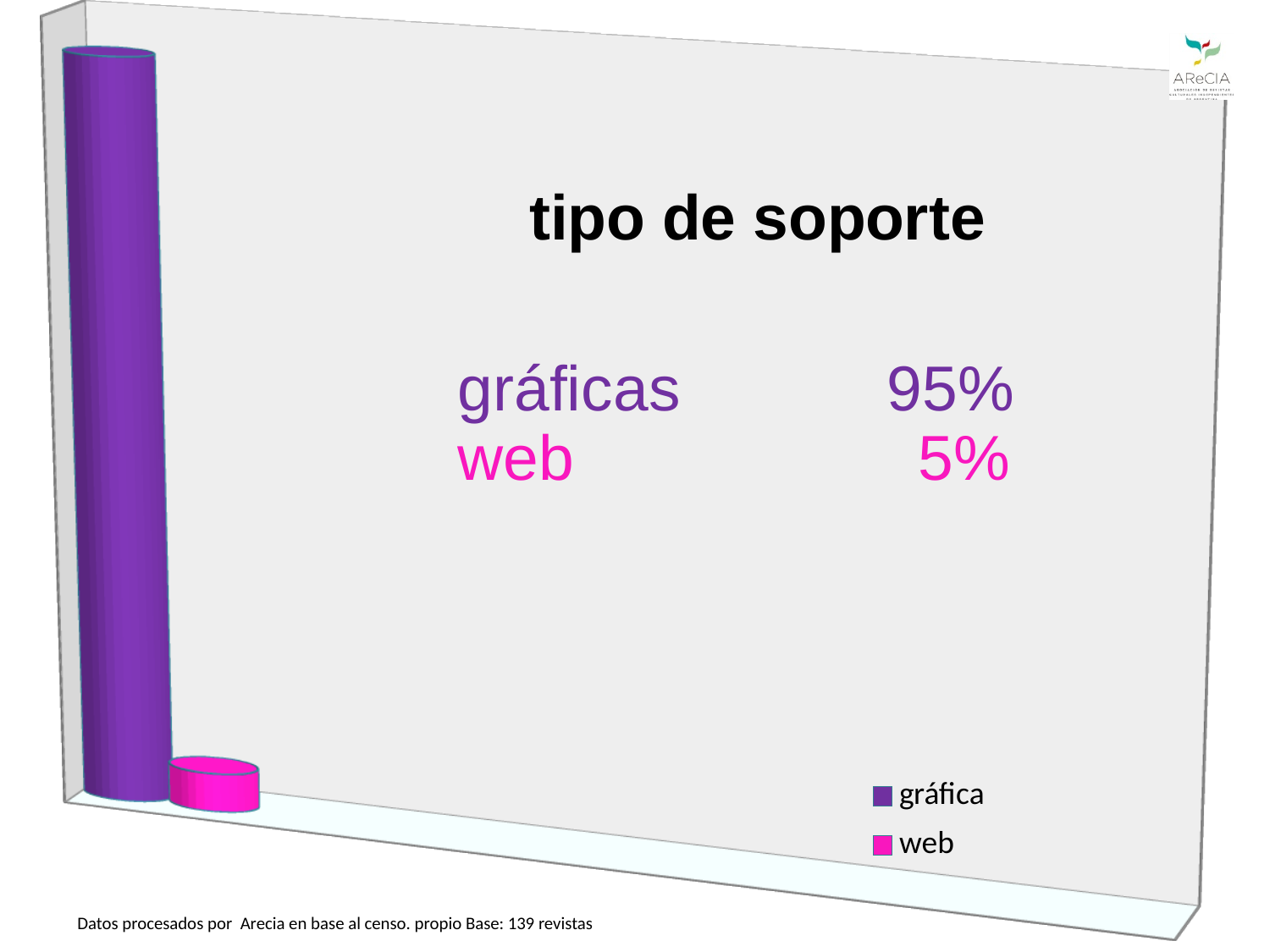
What is the title of the chart? tipo de soporte How many series does the legend list? 2 What colour is the bar for web? magenta What is the difference between the gráficas value and the web value? 90% Which category has the highest value? gráfica What percentage is shown for gráficas? 95% What is the total of the gráficas and web values? 100% Which is larger, the value for gráficas or the value for web? gráficas What kind of chart is shown on the slide? bar chart What percentage is shown for web? 5% How many bars are plotted in the chart? 2 Which category has the lowest value? web